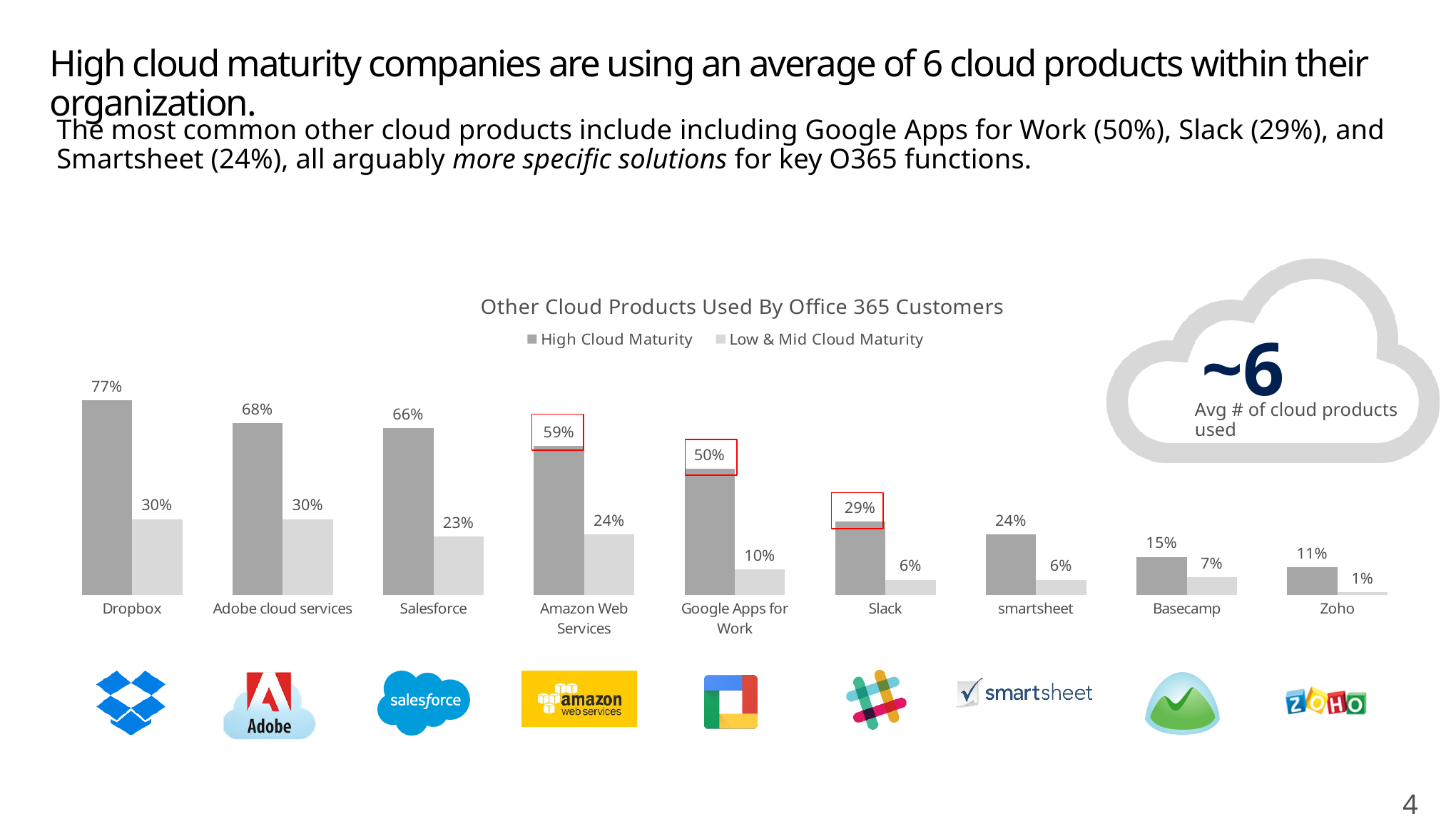
How many product categories are shown on the x axis? 9 How many series does the legend list? 2 What kind of chart is shown on the slide? Bar chart What is the Low & Mid Cloud Maturity value for Google Apps for Work? 10% Which category has the highest High Cloud Maturity value? Dropbox What is the difference between the High Cloud Maturity and Low & Mid Cloud Maturity values for Amazon Web Services? 35% What is the High Cloud Maturity value for Slack? 29% What is the title of the chart? Other Cloud Products Used By Office 365 Customers Which category has the lowest Low & Mid Cloud Maturity value? Zoho Do the High Cloud Maturity values rise or fall from left to right across the categories? Fall Which is larger: the High Cloud Maturity value for Salesforce or for Adobe cloud services? Adobe cloud services What is the High Cloud Maturity value for Dropbox? 77%